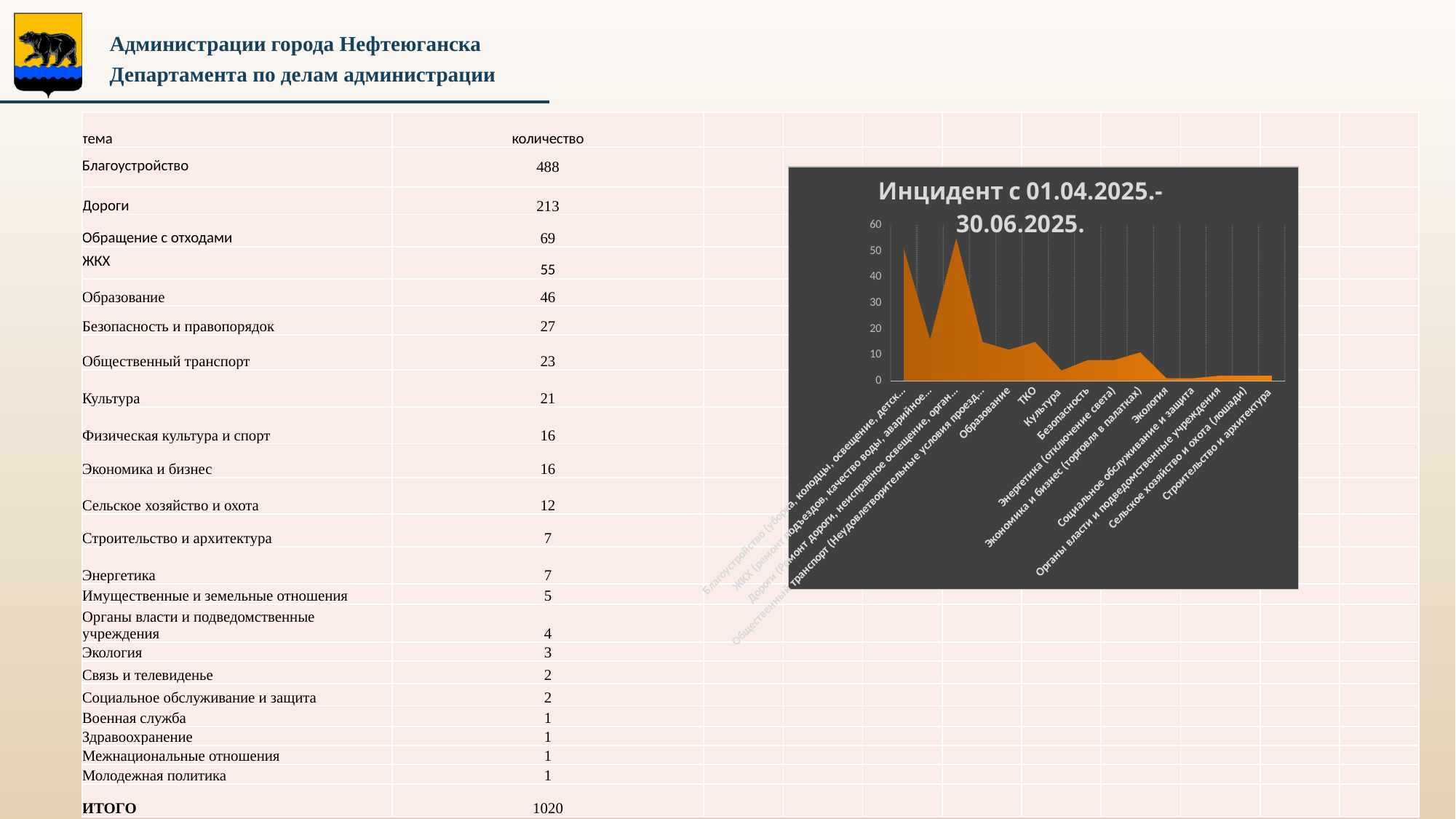
Which category has the highest value in the chart? Дороги What kind of chart is shown on the slide? area chart What is the title of the chart? Инцидент с 01.04.2025.-30.06.2025. Is the value for Благоустройство greater or less than 40? greater What is the highest value shown on the chart's vertical axis? 60 Is the value for ЖКХ greater or less than 20? less Which is larger, the value for Благоустройство or the value for Образование? Благоустройство How many categories are plotted along the x axis of the chart? 15 Is the value for Экология greater or less than 10? less Which is larger, the value for Дороги or the value for ЖКХ? Дороги